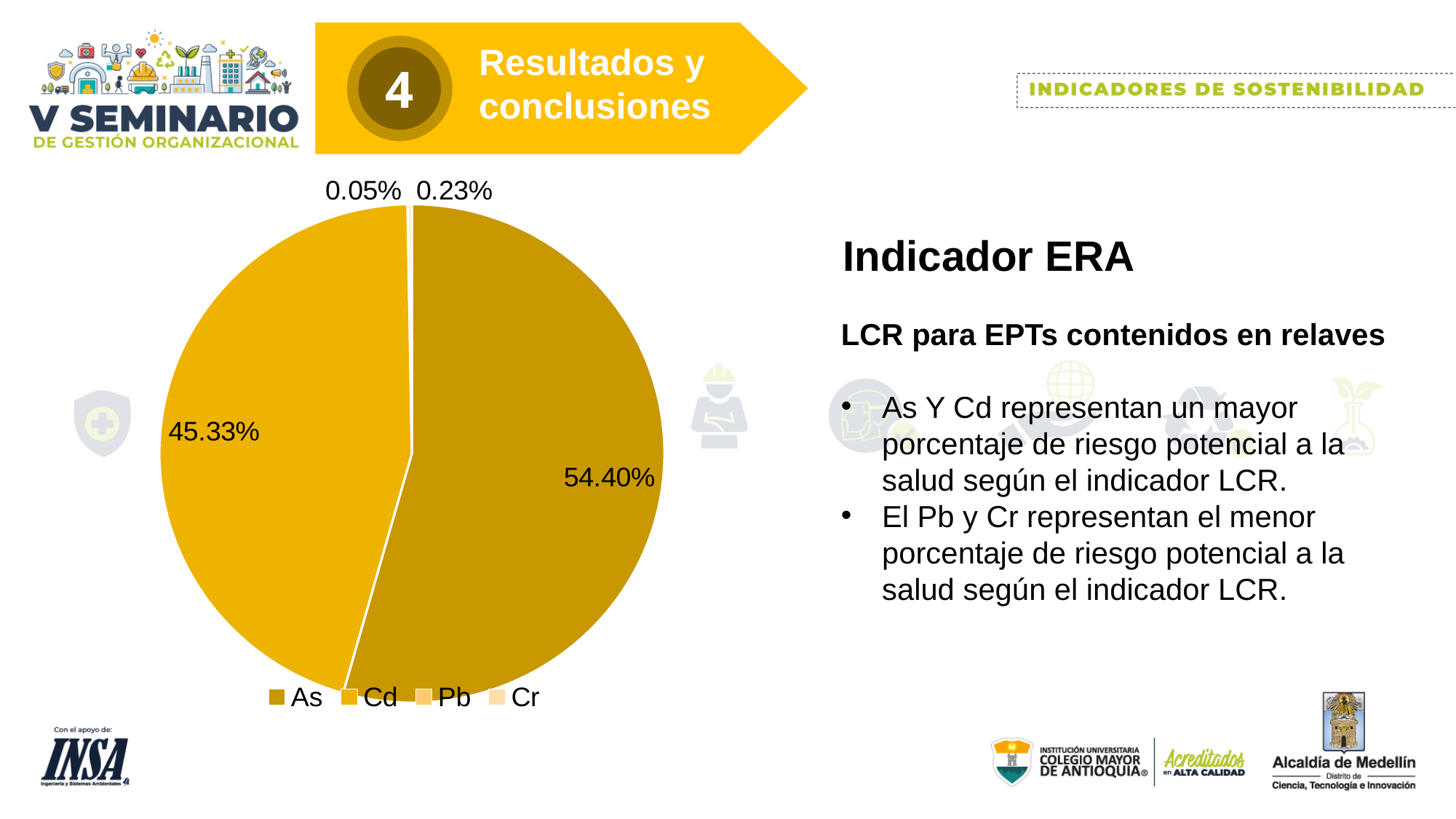
What share of the pie does As represent? 54.40% What is the combined share of As and Cd? 99.73% What is the difference between the As share and the Cd share? 9.07% How many categories are shown in the pie chart? 4 Is the share for Cd greater or less than 50%? less What share of the pie does Cd represent? 45.33% What type of chart is shown on the slide? pie chart What are the four categories listed in the legend? As, Cd, Pb, Cr Which category has the largest slice of the pie? As Is the share for As greater or less than 50%? greater Which is larger, the slice for As or the slice for Cd? As How many entries does the legend list? 4